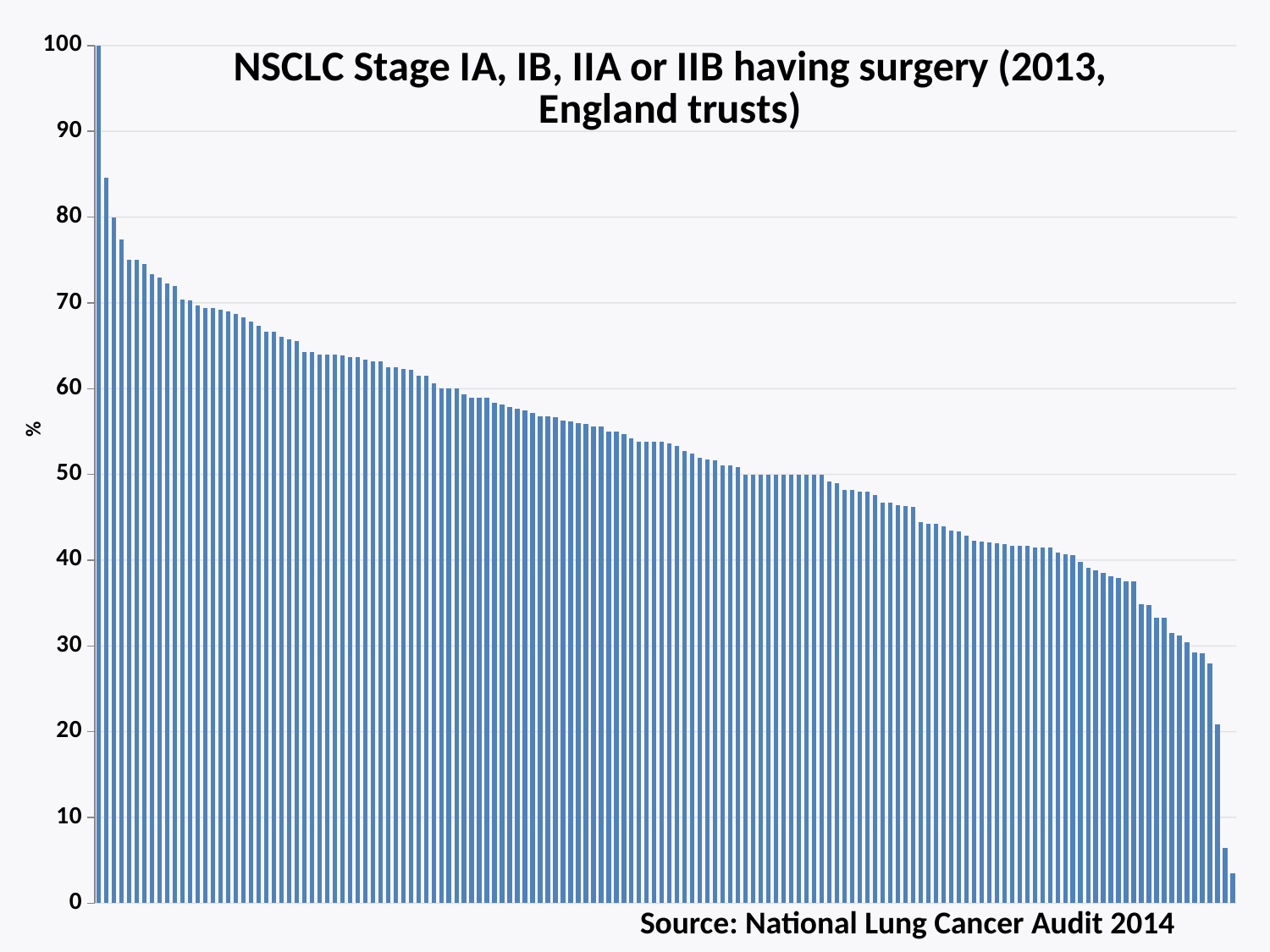
What is the title of the chart? NSCLC Stage IA, IB, IIA or IIB having surgery (2013, England trusts) What is the label on the vertical axis of the chart? % Do the bar values rise or fall from left to right across the chart? fall What kind of chart is shown on the slide? bar chart Is the value of the second bar from the left greater or less than 80? greater Is the value of the leftmost bar greater or less than 50? greater Which bar is higher, the leftmost bar or the rightmost bar? the leftmost bar Is the value of the tallest bar greater or less than 90? greater What is the highest value shown on the vertical axis? 100